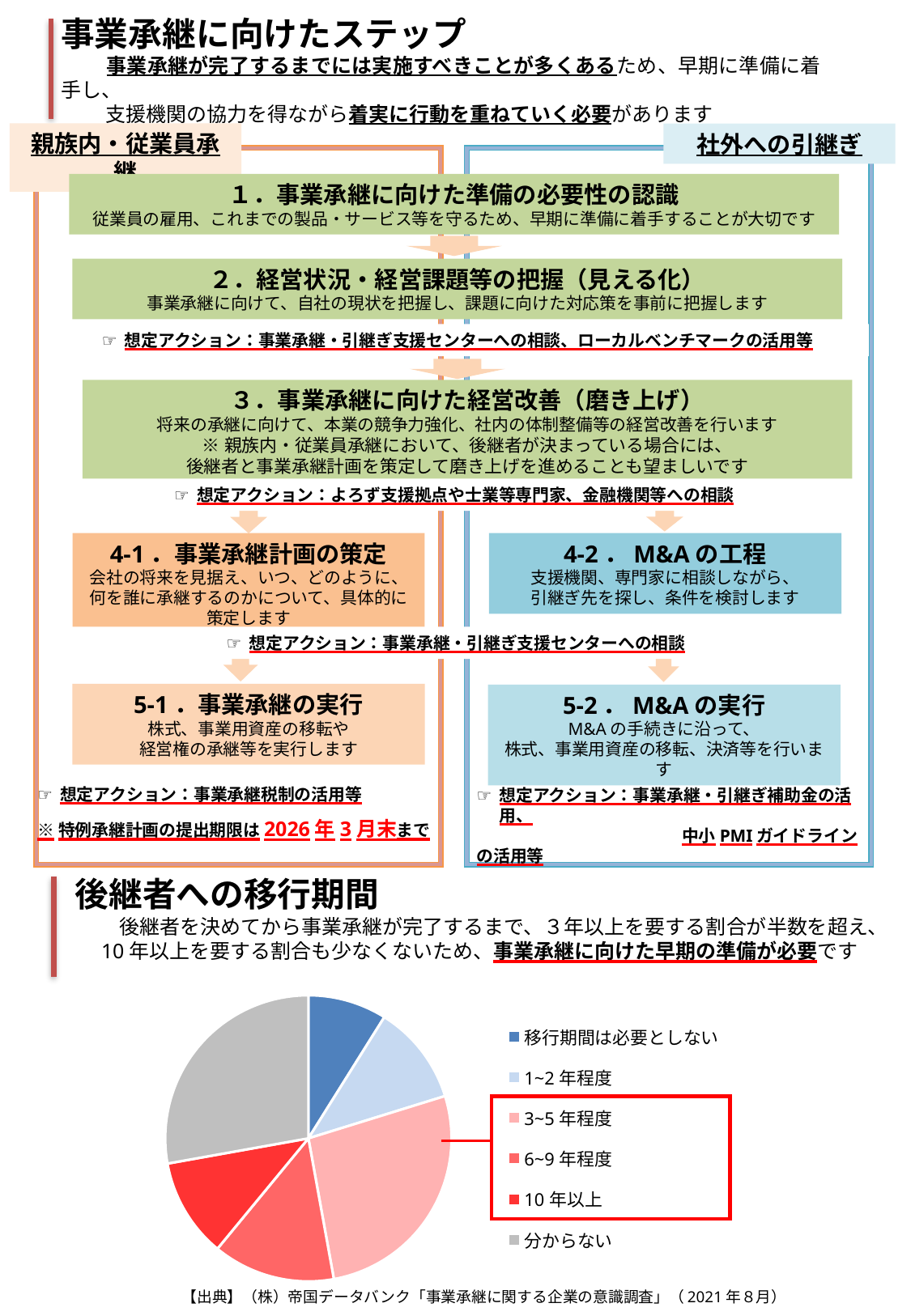
Which legend entries of the pie chart are enclosed in the red box? 3~5年程度, 6~9年程度, 10年以上 What colour is the 分からない slice in the pie chart? gray In the pie chart, which slice is larger: 10年以上 or 移行期間は必要としない? 10年以上 How many categories (slices) does the pie chart have? 6 What kind of chart is shown at the bottom of the slide under 後継者への移行期間? pie chart In the pie chart, which slice is larger: 3~5年程度 or 移行期間は必要としない? 3~5年程度 How many entries does the pie chart's legend list? 6